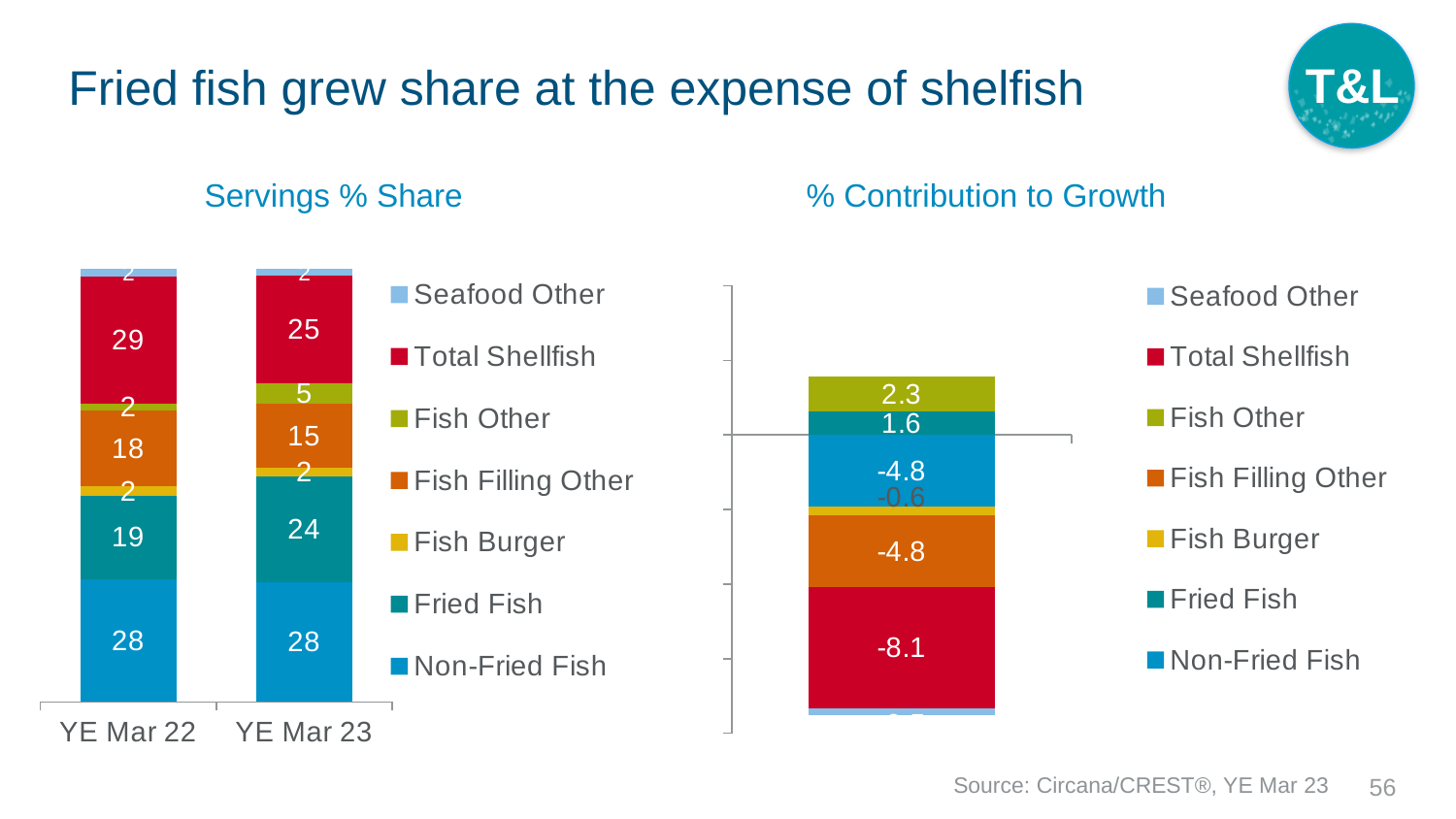
In the Servings % Share chart, which year has the larger Total Shellfish value, YE Mar 22 or YE Mar 23? YE Mar 22 What kind of chart is the Servings % Share chart? Stacked bar chart In the Servings % Share chart, what is the value for Non-Fried Fish in YE Mar 23? 28 In the Servings % Share chart, by how much did the Fried Fish value change from YE Mar 22 to YE Mar 23? 5 In the Servings % Share chart, what is the value for Total Shellfish in YE Mar 22? 29 How many series does the legend of the Servings % Share chart list? 7 In the % Contribution to Growth chart, what is the value for Total Shellfish? -8.1 In the Servings % Share chart, what is the difference between the Fish Filling Other values for YE Mar 22 and YE Mar 23? 3 In the % Contribution to Growth chart, which series has the lowest value? Total Shellfish How many bars are shown in the Servings % Share chart? 2 In the % Contribution to Growth chart, what is the value for Fish Other? 2.3 In the Servings % Share chart, what is the value for Fried Fish in YE Mar 23? 24